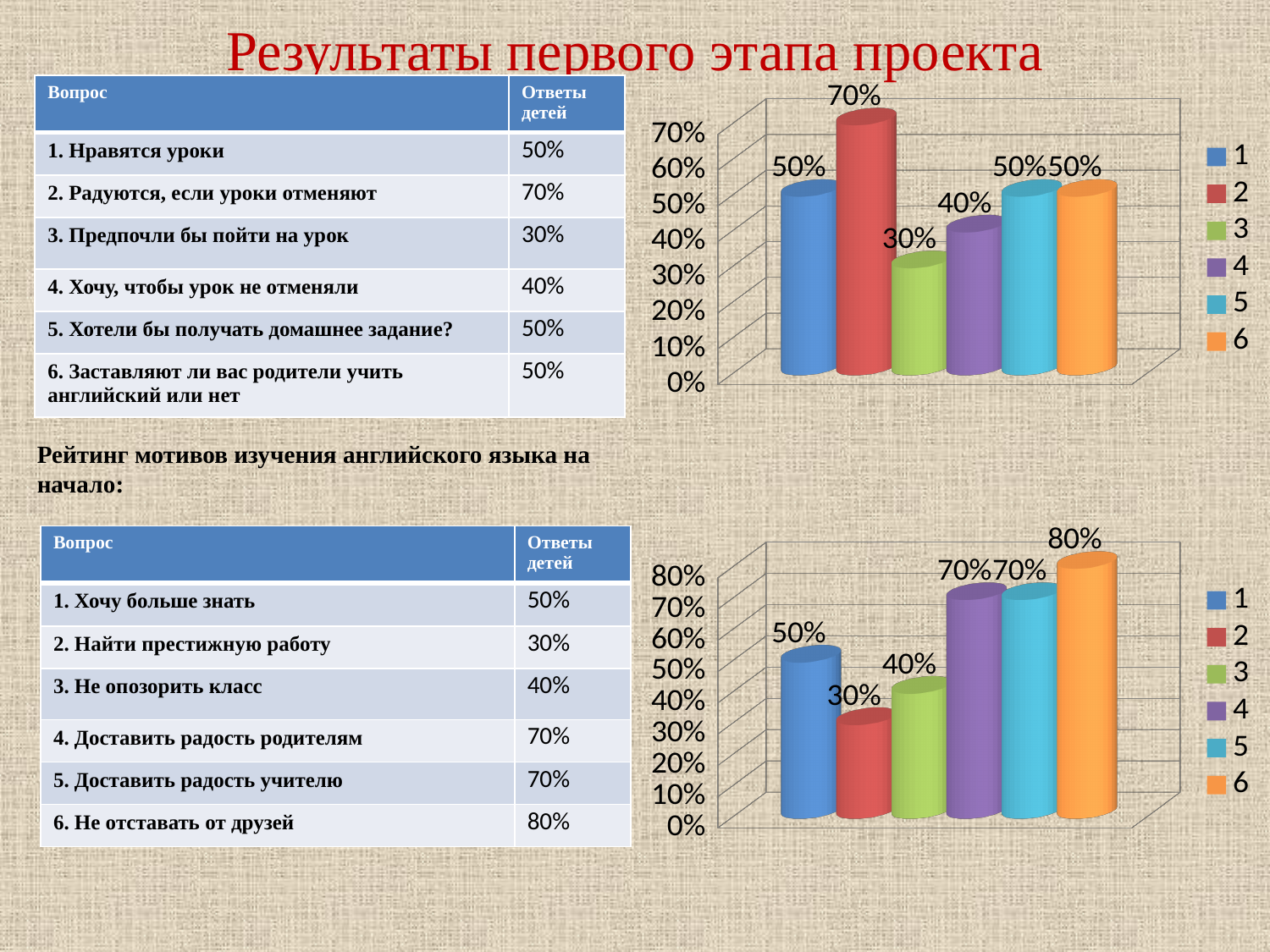
In the bottom chart, which series has the highest value? 6 In the top chart, how many bars are plotted? 6 In the bottom chart, which is larger, the value for series 1 or the value for series 3? series 1 In the top chart, what is the value for series 3? 30% In the top chart, which series has the highest value? 2 In the top chart, which series has the lowest value? 3 In the top chart, what is the value for series 2? 70% In the bottom chart, what is the difference between the values for series 6 and series 2? 50% In the bottom chart, what is the value for series 2? 30% How many entries does the legend of the bottom chart list? 6 In the top chart, what is the difference between the values for series 2 and series 4? 30% In the bottom chart, what is the value for series 6? 80%